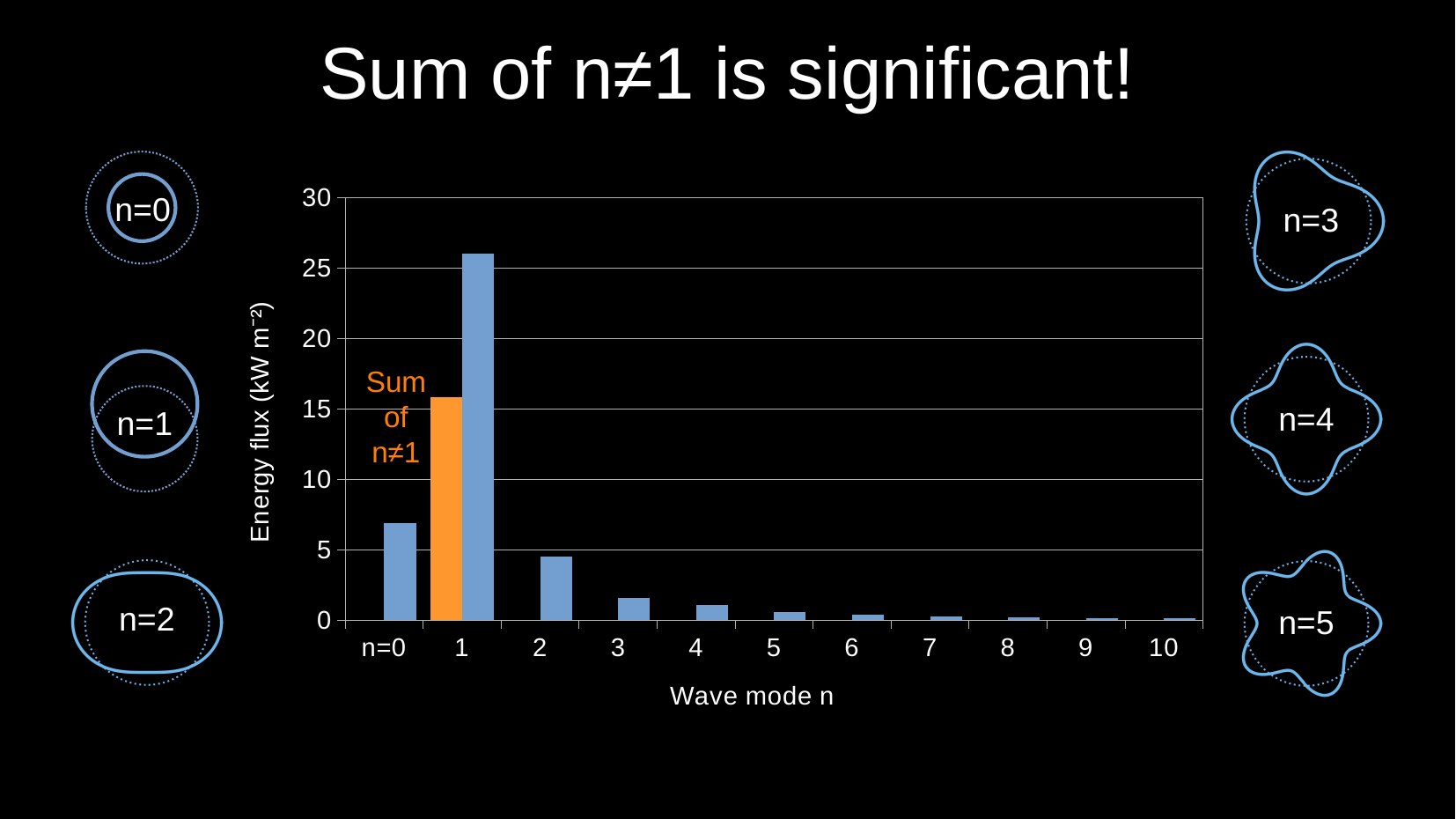
Is the value of the orange 'Sum of n≠1' bar greater or less than 15? greater What kind of chart is shown on the slide? bar chart Is the energy flux for wave mode n=2 greater or less than 5? less How many wave modes n are shown on the x axis? 11 Which is larger: the energy flux for n=0 or for n=2? n=0 Which is larger: the energy flux for n=1 or the 'Sum of n≠1' bar? n=1 Is the energy flux for wave mode n=1 greater or less than 25? greater Which wave mode has the highest energy flux? n=1 What is the label of the y axis? Energy flux (kW m⁻²) Do the energy flux values rise or fall as the wave mode n increases from 1 to 10? fall